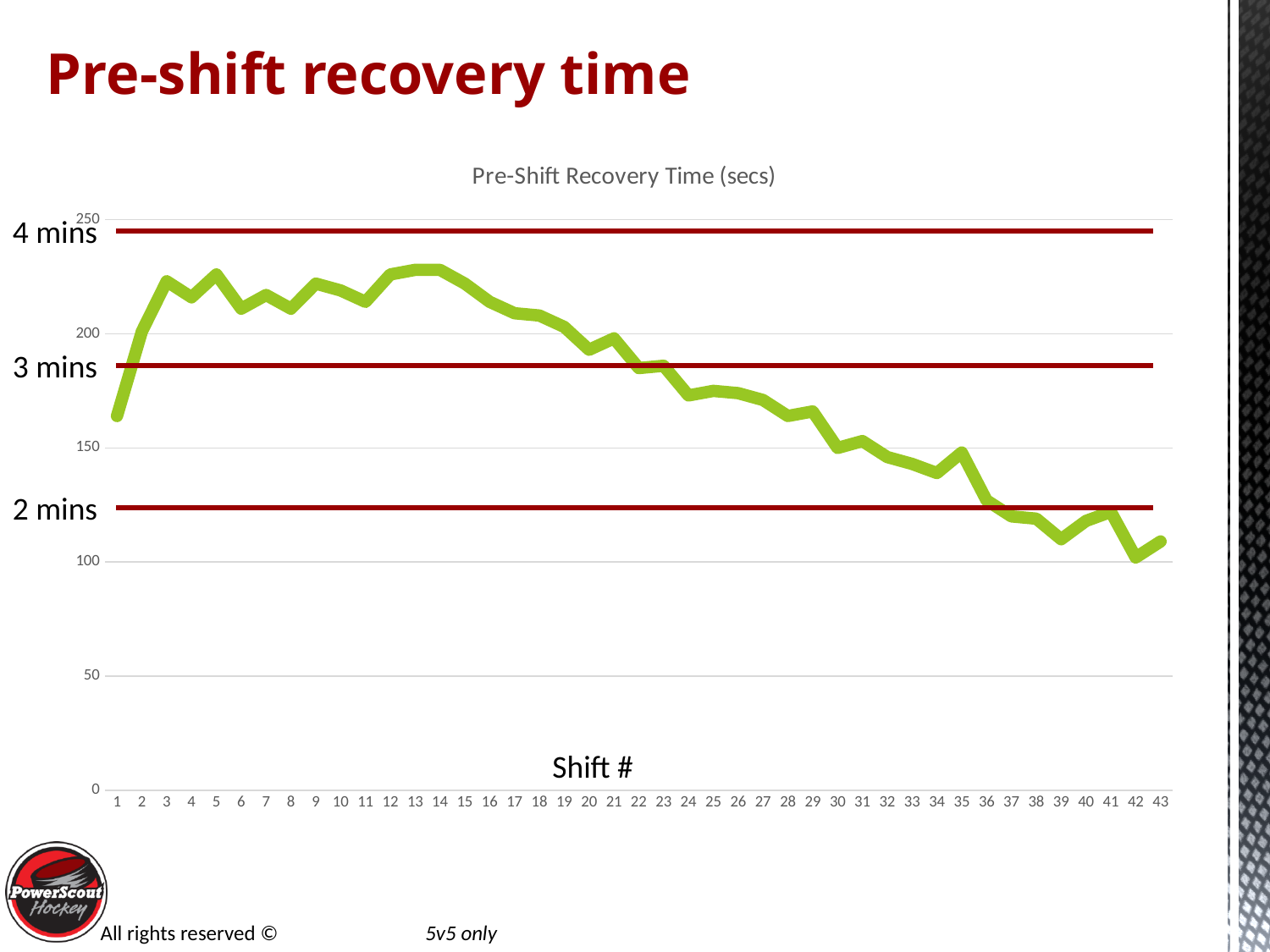
How many shifts are plotted along the x axis of the chart? 43 Does the pre-shift recovery time generally rise or fall as the shift number increases? fall Which has the higher pre-shift recovery time, shift 1 or shift 43? shift 1 What kind of chart is shown on the slide? line chart Is the pre-shift recovery time for shift 10 greater or less than 200? greater Is the pre-shift recovery time for shift 3 greater or less than 200? greater Is the pre-shift recovery time for shift 36 greater or less than 150? less What is the label of the x axis of the chart? Shift # What is the title of the chart? Pre-Shift Recovery Time (secs) Which has the higher pre-shift recovery time, shift 3 or shift 30? shift 3 Which shift has the lowest pre-shift recovery time? 42